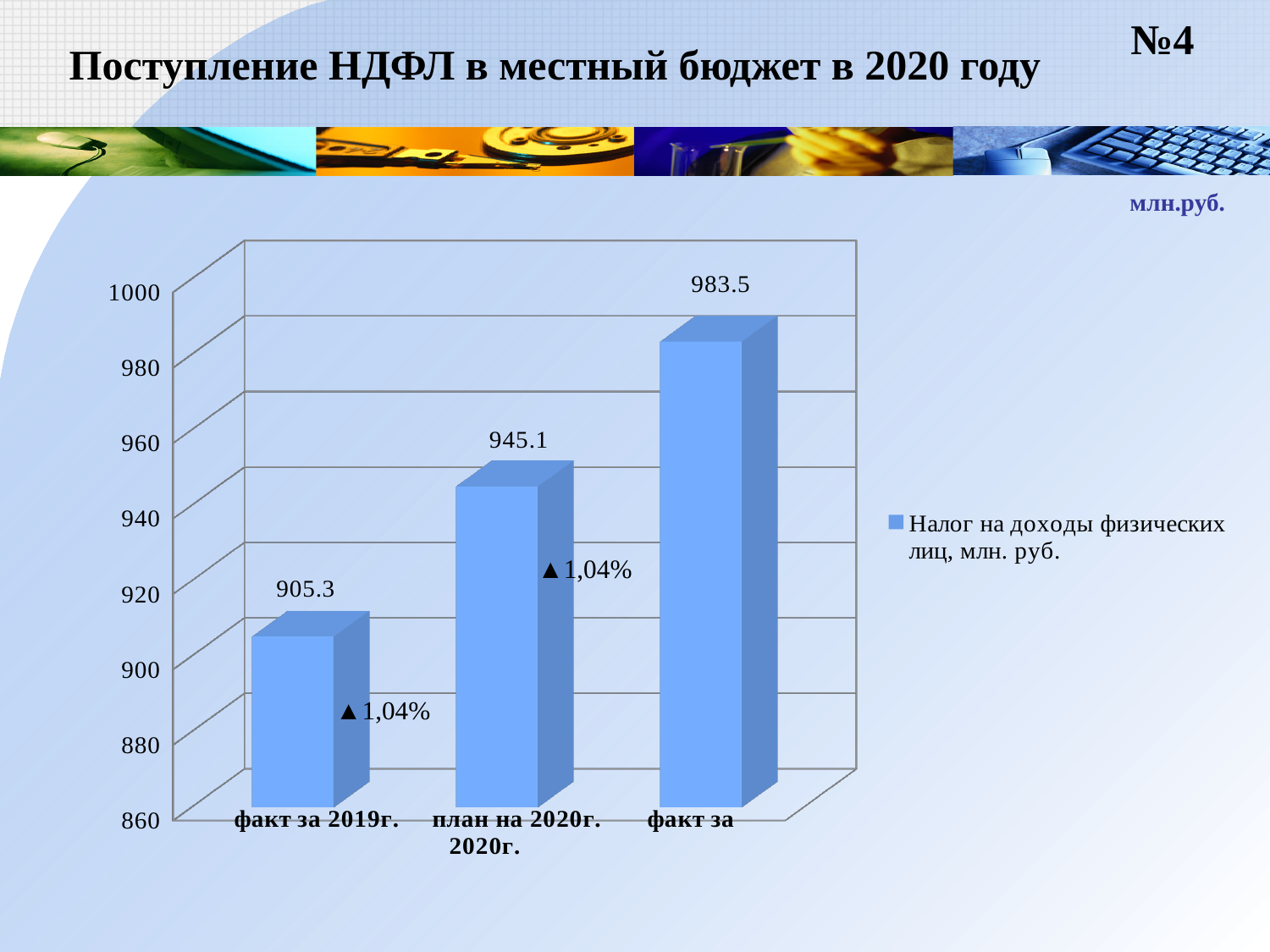
Do the values rise or fall from left to right along the x axis? rise What kind of chart is shown on the slide? bar chart What is the value for "план на 2020г."? 945.1 What is the value for "факт за 2019г."? 905.3 Is the value for "факт за 2020г." greater or less than 960? greater What is the difference between the values for "план на 2020г." and "факт за 2019г."? 39.8 Which is larger, the value for "план на 2020г." or the value for "факт за 2019г."? план на 2020г. What is the value for "факт за 2020г."? 983.5 How many categories are shown on the x axis? 3 What is the difference between the values for "факт за 2020г." and "план на 2020г."? 38.4 Which category has the highest value? факт за 2020г. Which category has the lowest value? факт за 2019г.